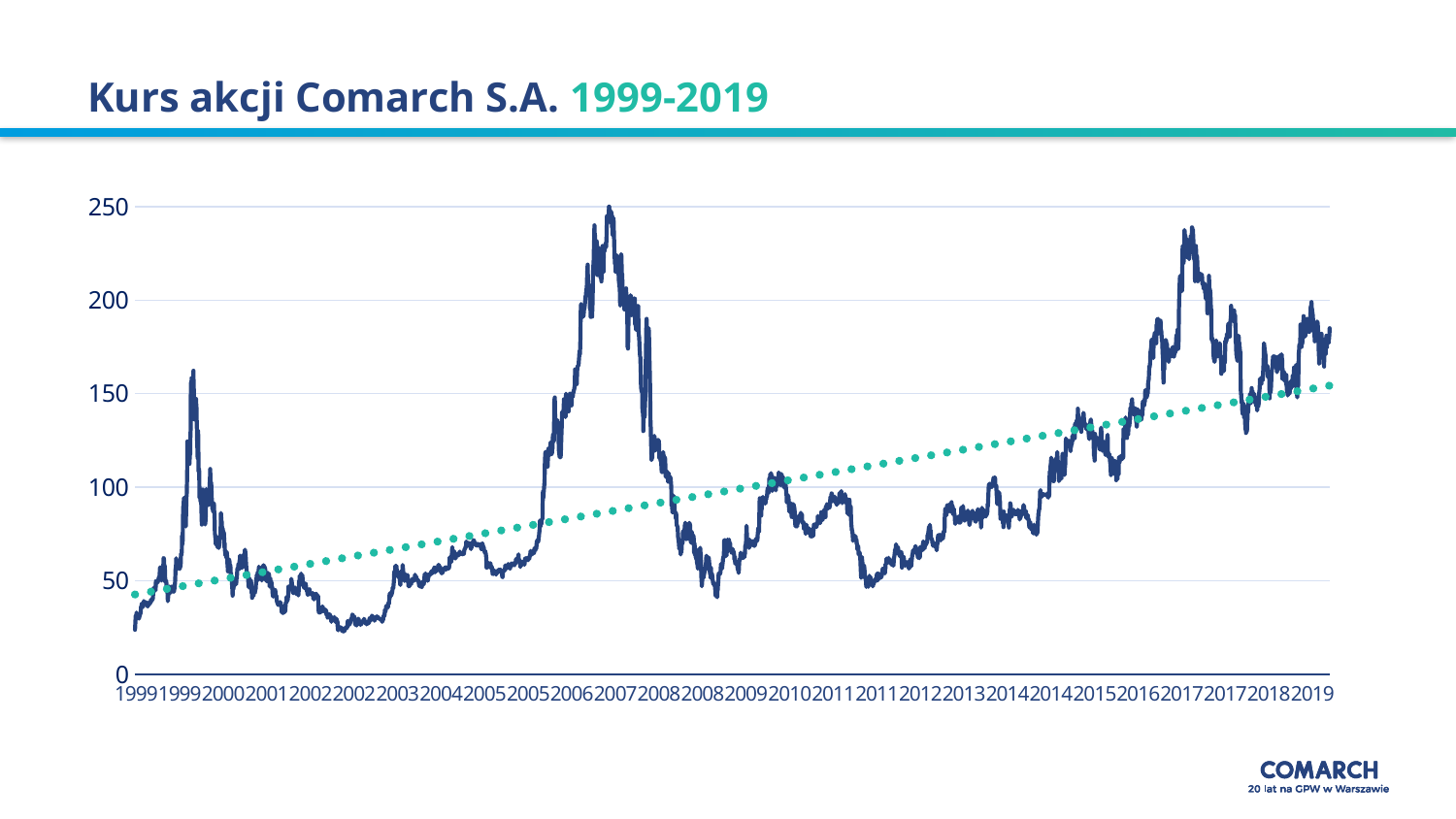
Is the peak value of the stock price in 2007 greater or less than 200? greater Is the stock price at the end of 2019 greater or less than 150? greater What is the highest value shown on the vertical axis? 250 Overall, does the stock price rise or fall from 1999 to 2019? rise What kind of chart is shown on the slide? line chart Is the lowest value of the stock price in 2002 greater or less than 50? less What is the title of the chart? Kurs akcji Comarch S.A. 1999-2019 In which year does the stock price reach its highest point? 2007 In which year does the stock price reach its lowest point? 2002 Which is higher: the peak of the stock price in 2007 or the peak in 1999? 2007